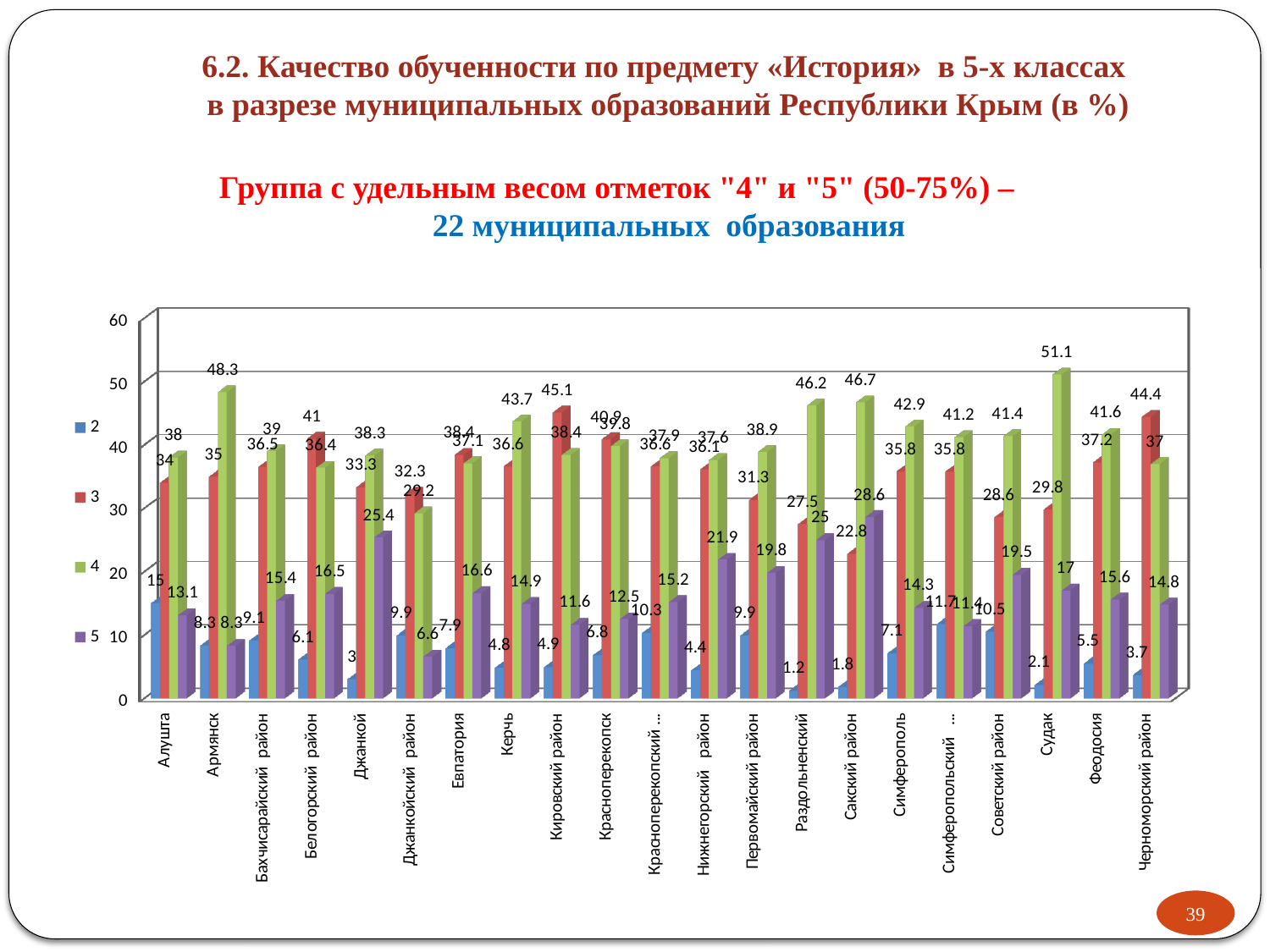
What are the legend entries of the chart? 2, 3, 4, 5 Is the value of series "4" for Судак greater or less than 50? greater What is the value of series "4" for Судак? 51.1 Which category has the highest value in series "4"? Судак What is the value of series "3" for Сакский район? 22.8 What is the difference between series "4" and series "3" for Армянск? 13.3 Which category has the lowest value in series "2"? Раздольненский What kind of chart is shown on the slide? bar chart What is the value of series "2" for Алушта? 15 How many series does the legend list? 4 Which is larger: series "5" for Сакский район or series "5" for Джанкой? Сакский район What is the value of series "5" for Нижнегорский район? 21.9